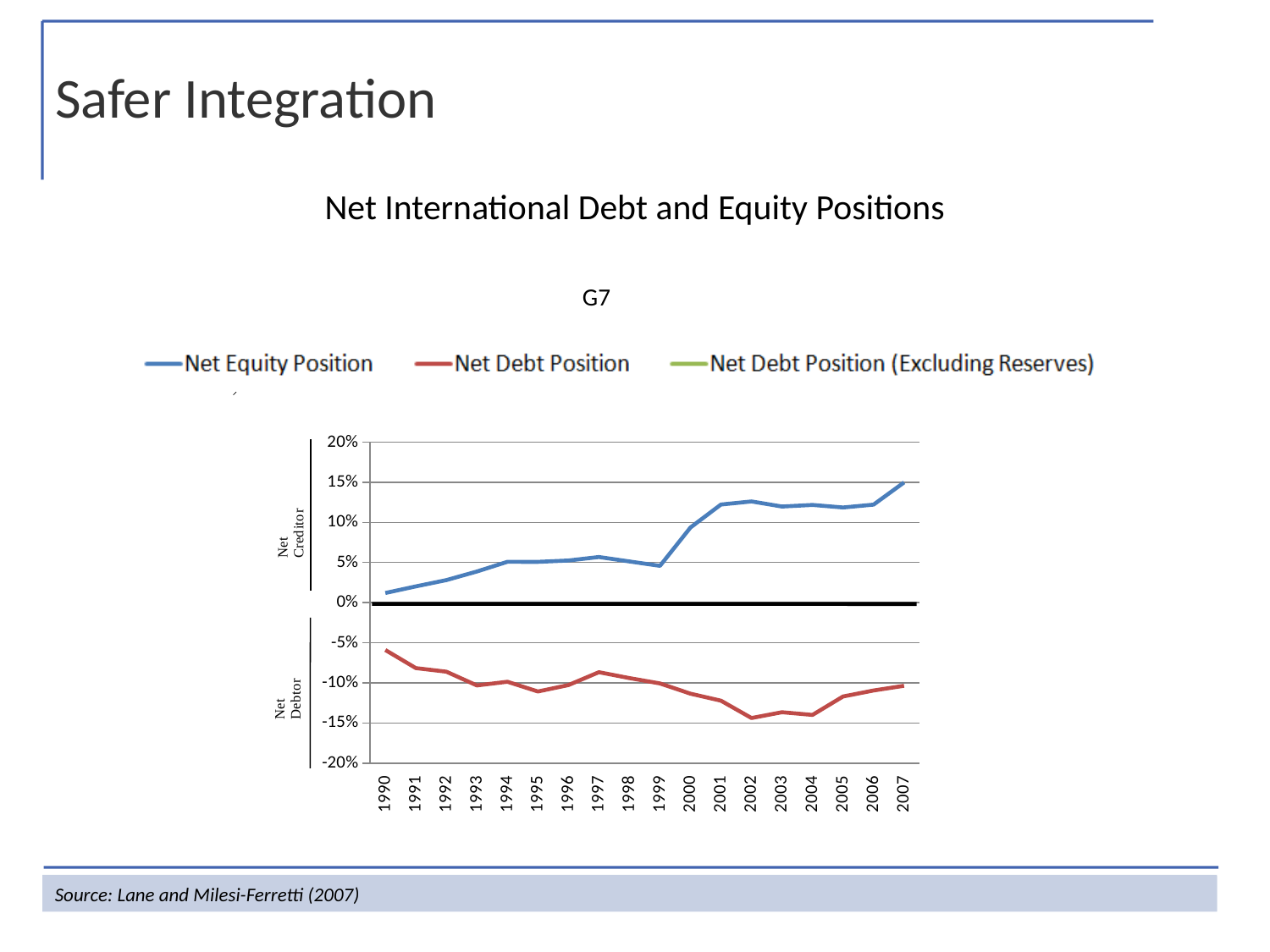
What kind of chart is shown on the slide? line chart Is the Net Debt Position in 1990 greater or less than -10%? greater How many years are shown on the x axis of the chart? 18 In which year is the Net Equity Position at its lowest? 1990 Is the Net Equity Position in 2007 greater or less than 10%? greater In which year is the Net Equity Position at its highest? 2007 How many series does the chart legend list? 3 In which year is the Net Debt Position at its highest (least negative)? 1990 What is the title of the chart? Net International Debt and Equity Positions Is the Net Equity Position in 1990 greater or less than 5%? less Does the Net Equity Position generally rise or fall from 1990 to 2007? rise